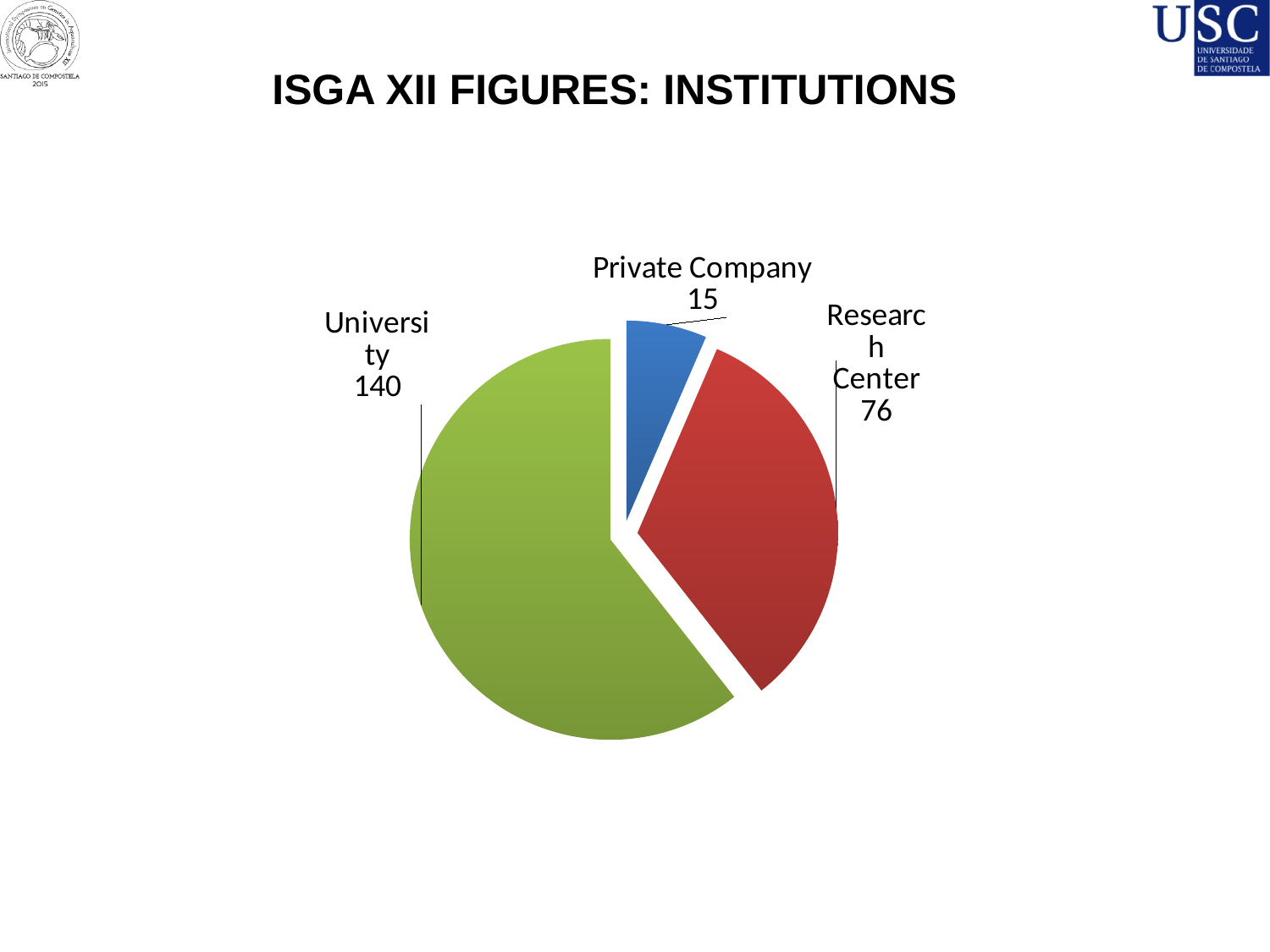
Which is larger, Research Center or Private Company? Research Center How many categories are shown in the pie chart? 3 Which category has the smallest slice of the pie? Private Company What is the value for Private Company? 15 What type of chart is shown on the slide? pie chart What is the total of all three slices in the pie chart? 231 Which category has the largest slice of the pie? University What is the value for University? 140 What is the value for Research Center? 76 What is the difference between the Research Center value and the Private Company value? 61 What is the title of the slide containing the chart? ISGA XII FIGURES: INSTITUTIONS What is the difference between the University value and the Research Center value? 64